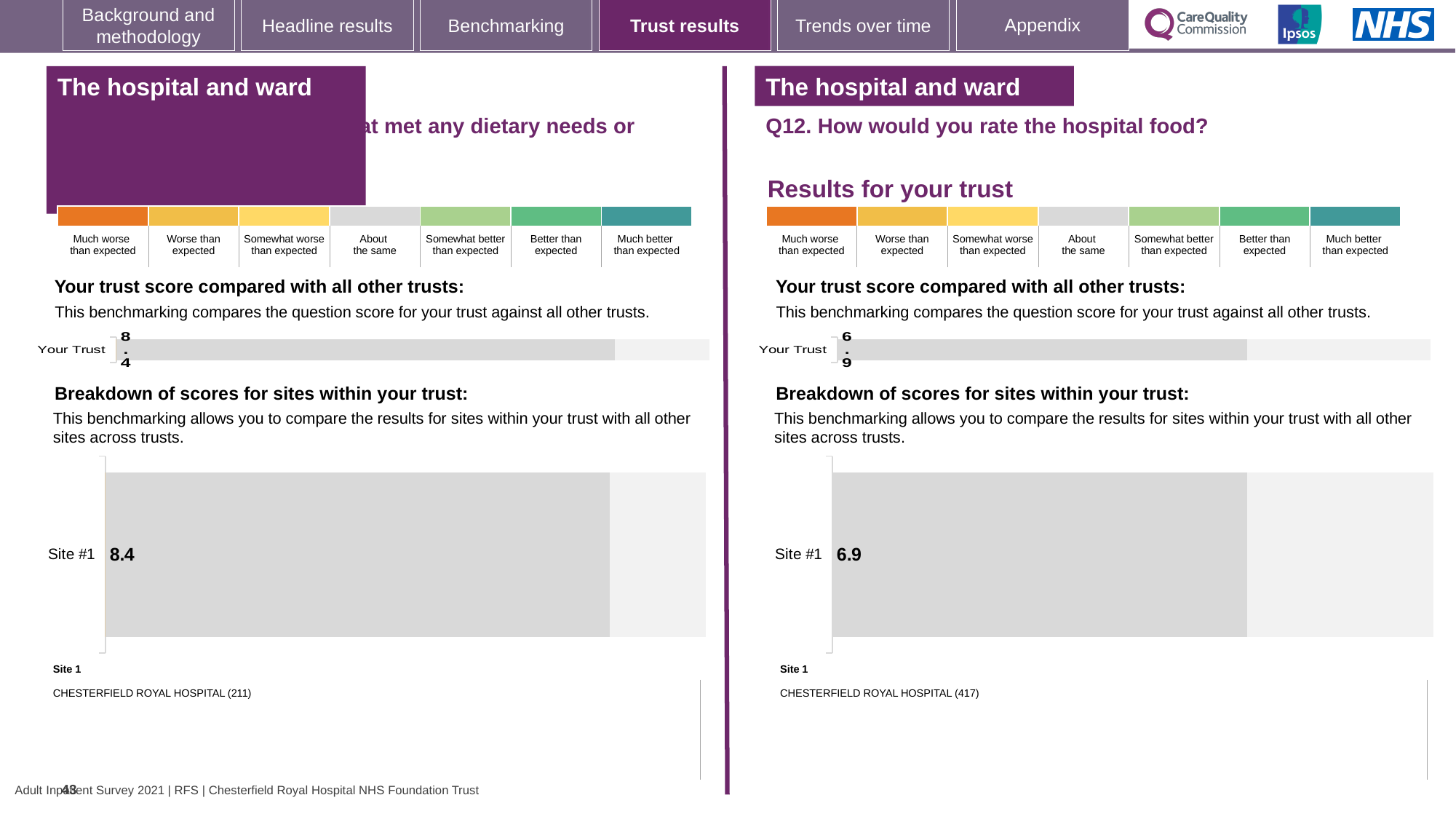
On the left-hand chart, what is the score shown for Site #1? 8.4 How many sites are shown in the breakdown of scores chart on the left-hand side? 1 How many sites are shown in the breakdown of scores chart on the right-hand side for Q12? 1 On the left-hand chart, what is the score shown for Your Trust? 8.4 On the right-hand chart for Q12 (How would you rate the hospital food?), what is the score shown for Your Trust? 6.9 Which is larger: the Site #1 score on the left-hand chart or the Site #1 score on the right-hand chart for Q12? Left-hand chart (8.4) On the right-hand chart for Q12, what is the score shown for Site #1? 6.9 What is the difference between the Site #1 score on the left-hand chart and the Site #1 score on the right-hand chart for Q12? 1.5 What kind of chart is used to show the Site #1 score on the right-hand side for Q12? Bar chart On the right-hand side for Q12, which site name is listed as Site 1? CHESTERFIELD ROYAL HOSPITAL (417) On the left-hand side, which site name is listed as Site 1? CHESTERFIELD ROYAL HOSPITAL (211)